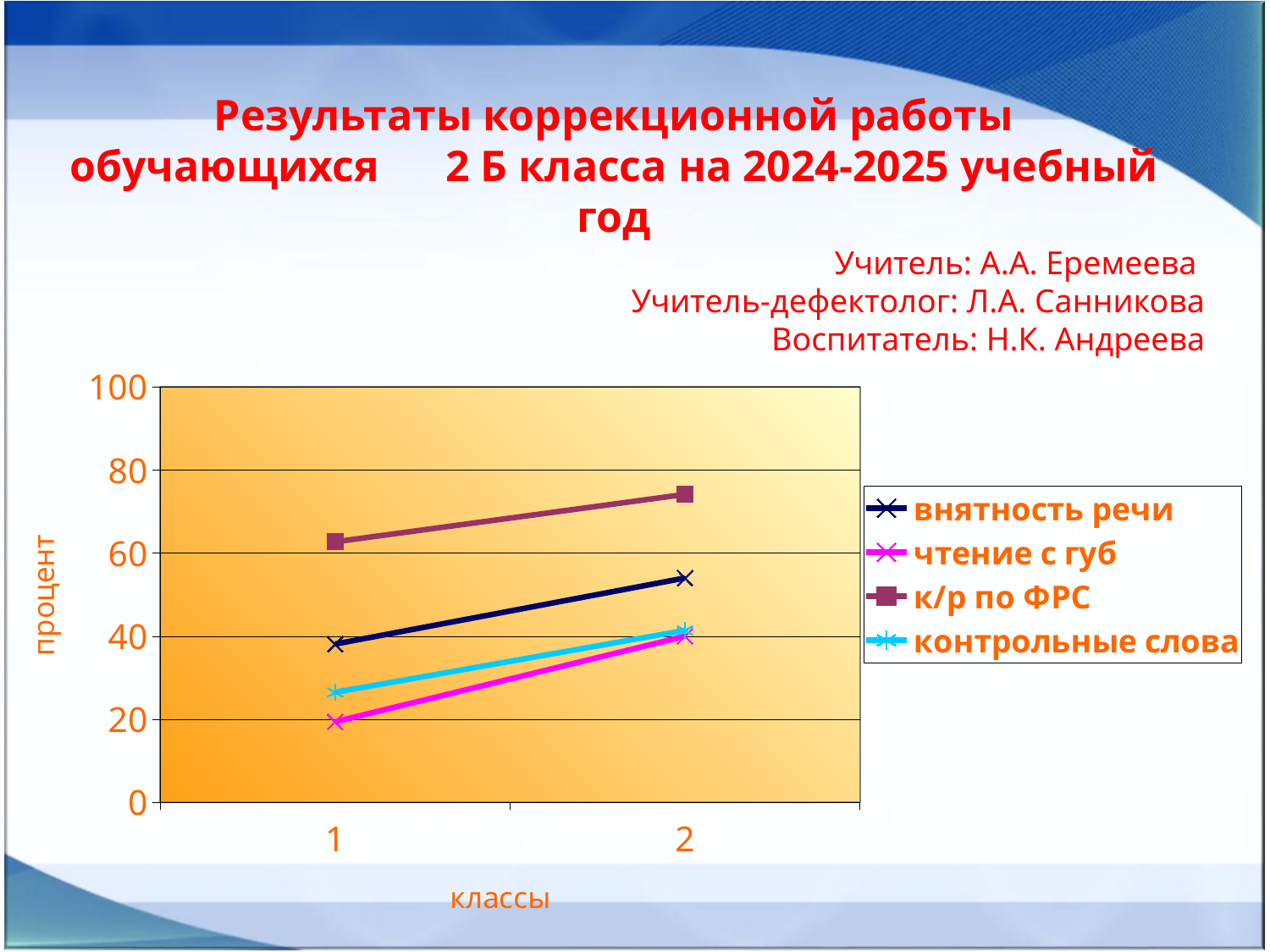
Is the value for внятность речи at class 2 greater or less than 40? greater Is the value for к/р по ФРС at class 2 greater or less than 60? greater Does the value for чтение с губ rise or fall from class 1 to class 2? rise Does the value for внятность речи rise or fall from class 1 to class 2? rise What is the label of the y axis? процент At class 1, which is larger: внятность речи or контрольные слова? внятность речи How many categories are shown on the x axis? 2 Which series has the highest value at class 2? к/р по ФРС How many series does the legend list? 4 What kind of chart is shown on the slide? line chart Which series has the lowest value at class 1? чтение с губ Is the value for чтение с губ at class 1 greater or less than 40? less